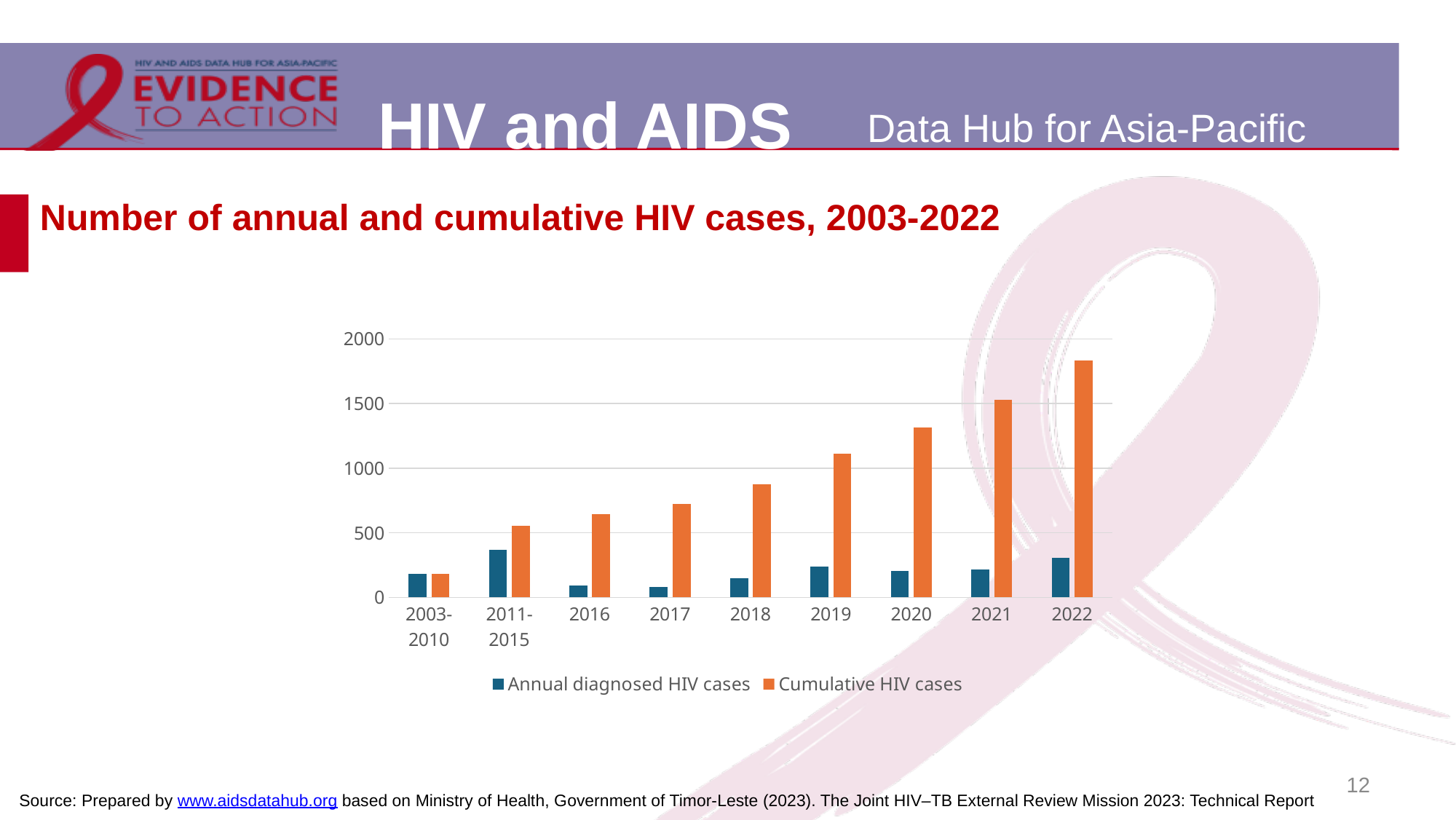
Do the values for Cumulative HIV cases rise or fall from 2016 to 2022? rise Is the value for Cumulative HIV cases in 2022 greater or less than 1500? greater Is the value for Annual diagnosed HIV cases in 2011-2015 greater or less than 500? less How many categories are shown on the x axis? 9 Is the value for Cumulative HIV cases in 2020 greater or less than 1000? greater Which category has the highest value for Cumulative HIV cases? 2022 How many series does the legend list? 2 Which category has the highest value for Annual diagnosed HIV cases? 2011-2015 Which is larger, Annual diagnosed HIV cases in 2019 or in 2018? 2019 What type of chart is shown on the slide? Bar chart What is the title of the chart? Number of annual and cumulative HIV cases, 2003-2022